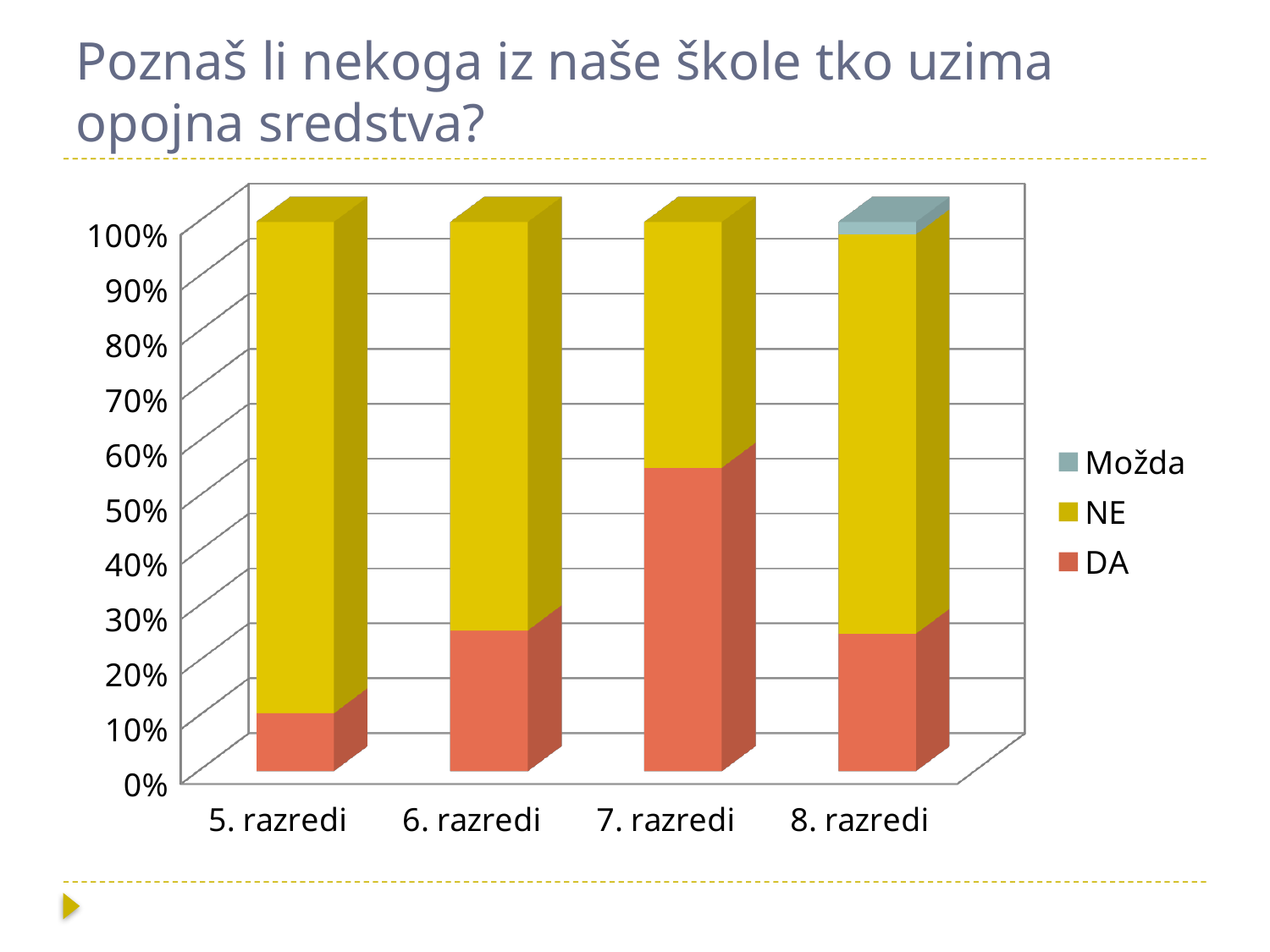
How many series does the legend list? 3 Which has a larger DA share, 5. razredi or 7. razredi? 7. razredi Which category has the smallest DA share? 5. razredi Is the DA value for 7. razredi greater or less than 50%? greater Which category is the only one with a Možda segment? 8. razredi How many categories (class groups) are shown on the x axis? 4 Is the DA value for 5. razredi greater or less than 20%? less Which category has the largest DA share? 7. razredi Is the NE value for 7. razredi greater or less than 50%? less What kind of chart is shown on the slide? Stacked bar chart What are the three legend entries of the chart? Možda, NE, DA